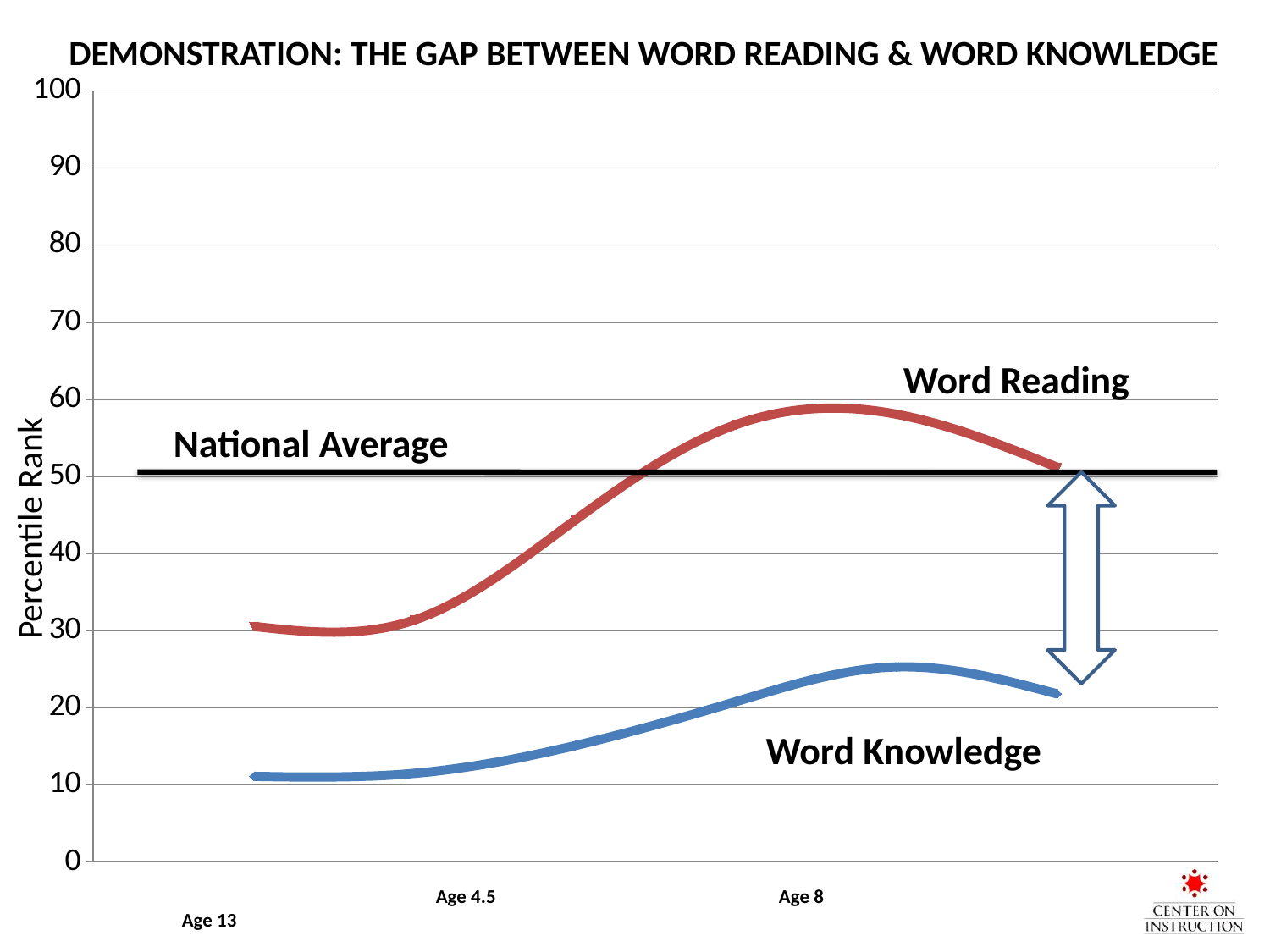
Is the starting value of the Word Knowledge line on the left greater or less than 20? less Which line is higher across the chart, Word Reading or Word Knowledge? Word Reading How many age labels are shown along the x axis? 3 What is the title of the chart? DEMONSTRATION: THE GAP BETWEEN WORD READING & WORD KNOWLEDGE Does the Word Reading line rise or fall between its left end and its peak? rise What kind of chart is shown on the slide? line chart Is the peak value of the Word Knowledge line greater or less than 30? less What colour is the Word Reading line? red Does the Word Knowledge line end higher or lower than it starts? higher Is the starting value of the Word Reading line on the left greater or less than 40? less At what percentile rank does the National Average line sit? 50